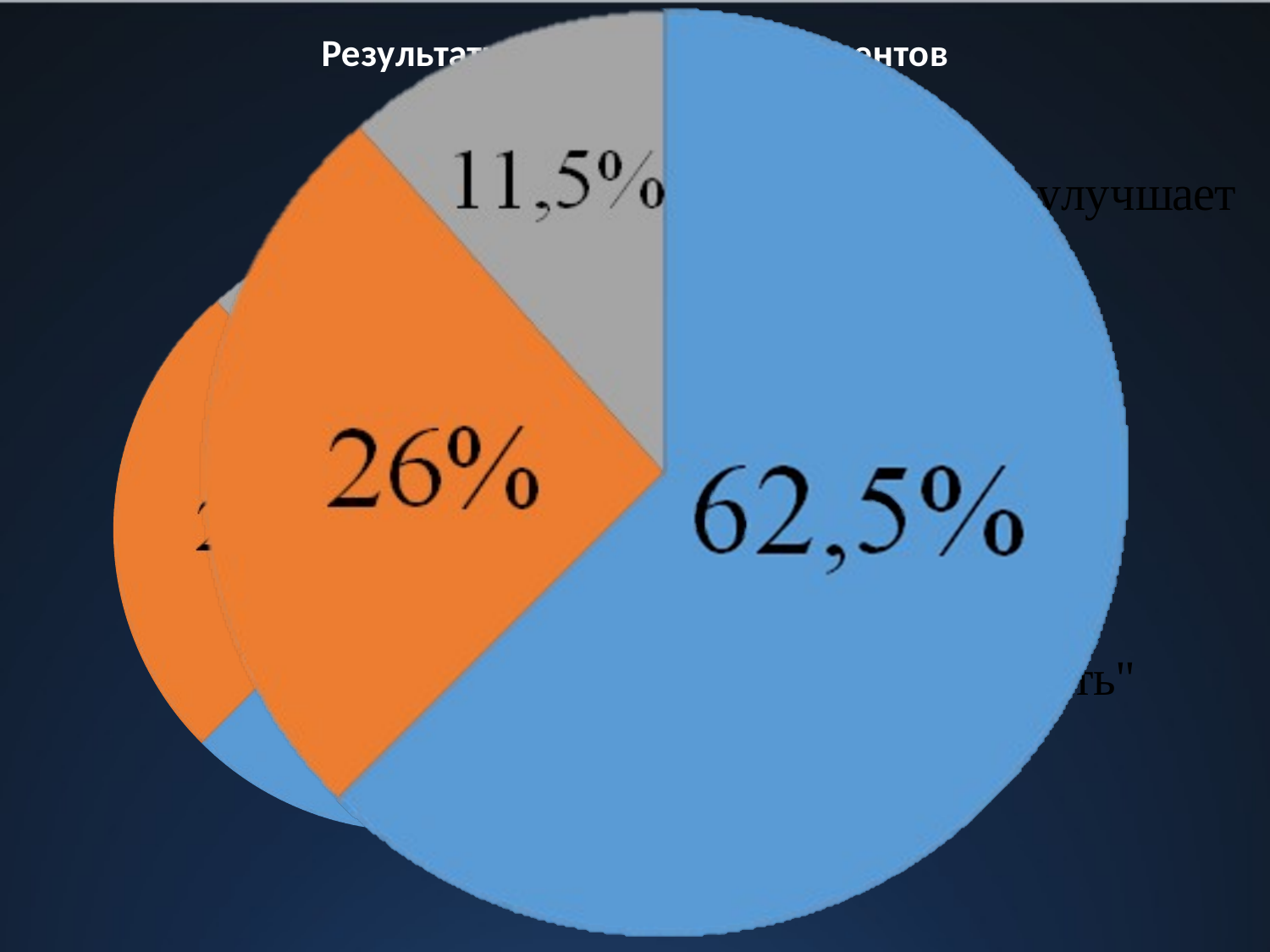
What kind of chart is shown on the slide? pie chart What colour is the largest slice of the pie chart? blue What percentage is shown on the grey slice of the pie chart? 11,5% How many slices does the large pie chart have? 3 What is the difference between the orange slice and the grey slice of the pie chart? 14,5% Which slice of the pie chart is the smallest? the grey slice (11,5%) Which is larger in the pie chart, the orange slice or the grey slice? the orange slice What is the difference between the blue slice and the orange slice of the pie chart? 36,5% What percentage is shown on the orange slice of the pie chart? 26% What percentage is shown on the blue slice of the pie chart? 62,5% Which slice of the pie chart is the largest? the blue slice (62,5%) Is the blue slice of the pie chart greater or less than 50% of the whole? greater